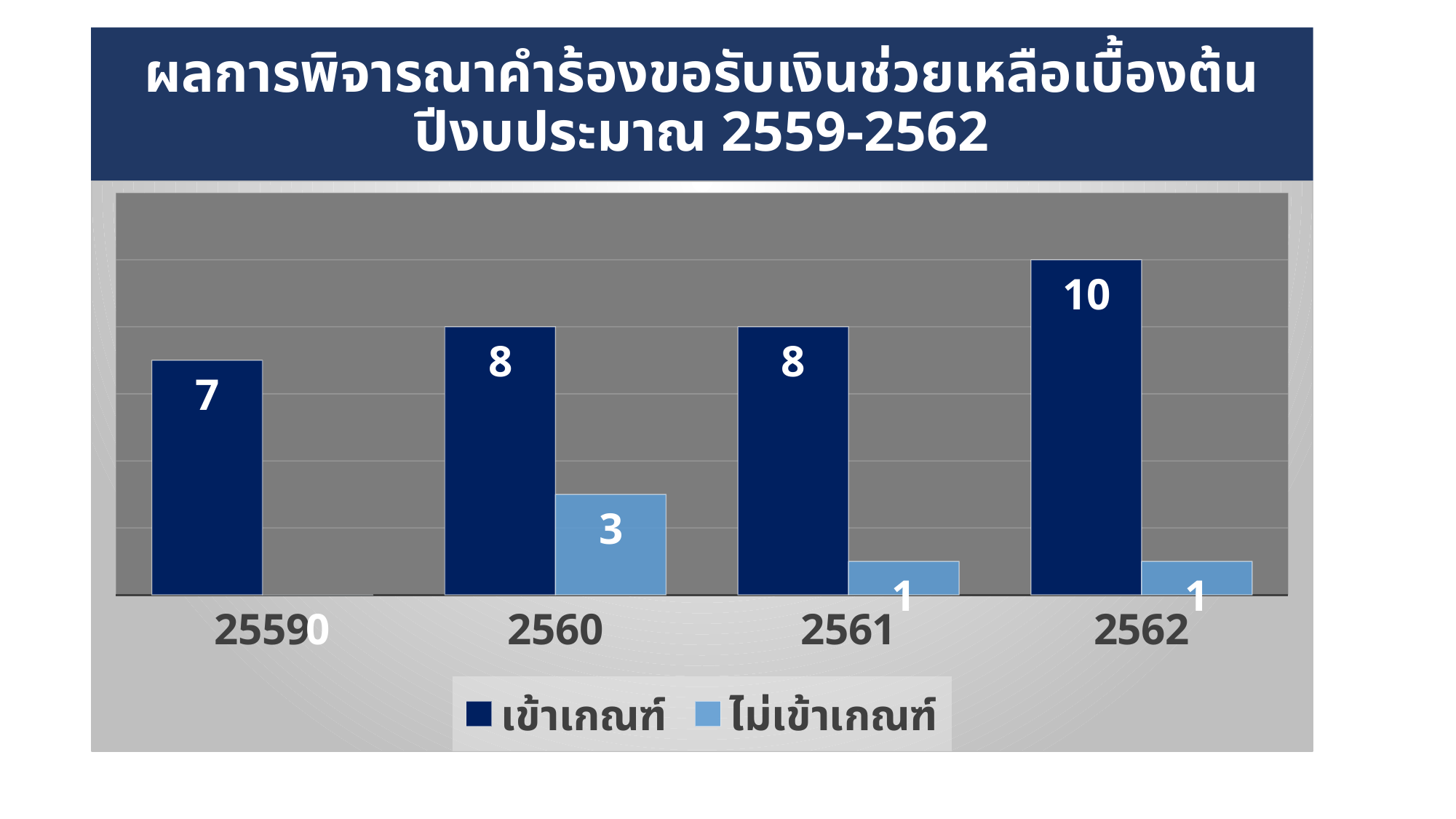
What is the difference between the เข้าเกณฑ์ values for 2562 and 2559? 3 What kind of chart is shown on the slide? Bar chart How many series does the legend list? 2 What is the value of ไม่เข้าเกณฑ์ for 2560? 3 Which year has the highest value for ไม่เข้าเกณฑ์? 2560 What is the value of เข้าเกณฑ์ for 2562? 10 What is the value of เข้าเกณฑ์ for 2559? 7 Which year has the highest value for เข้าเกณฑ์? 2562 Which year has the lowest value for เข้าเกณฑ์? 2559 What is the value of ไม่เข้าเกณฑ์ for 2561? 1 Which is larger: เข้าเกณฑ์ for 2560 or ไม่เข้าเกณฑ์ for 2560? เข้าเกณฑ์ for 2560 How many years are shown on the x axis? 4